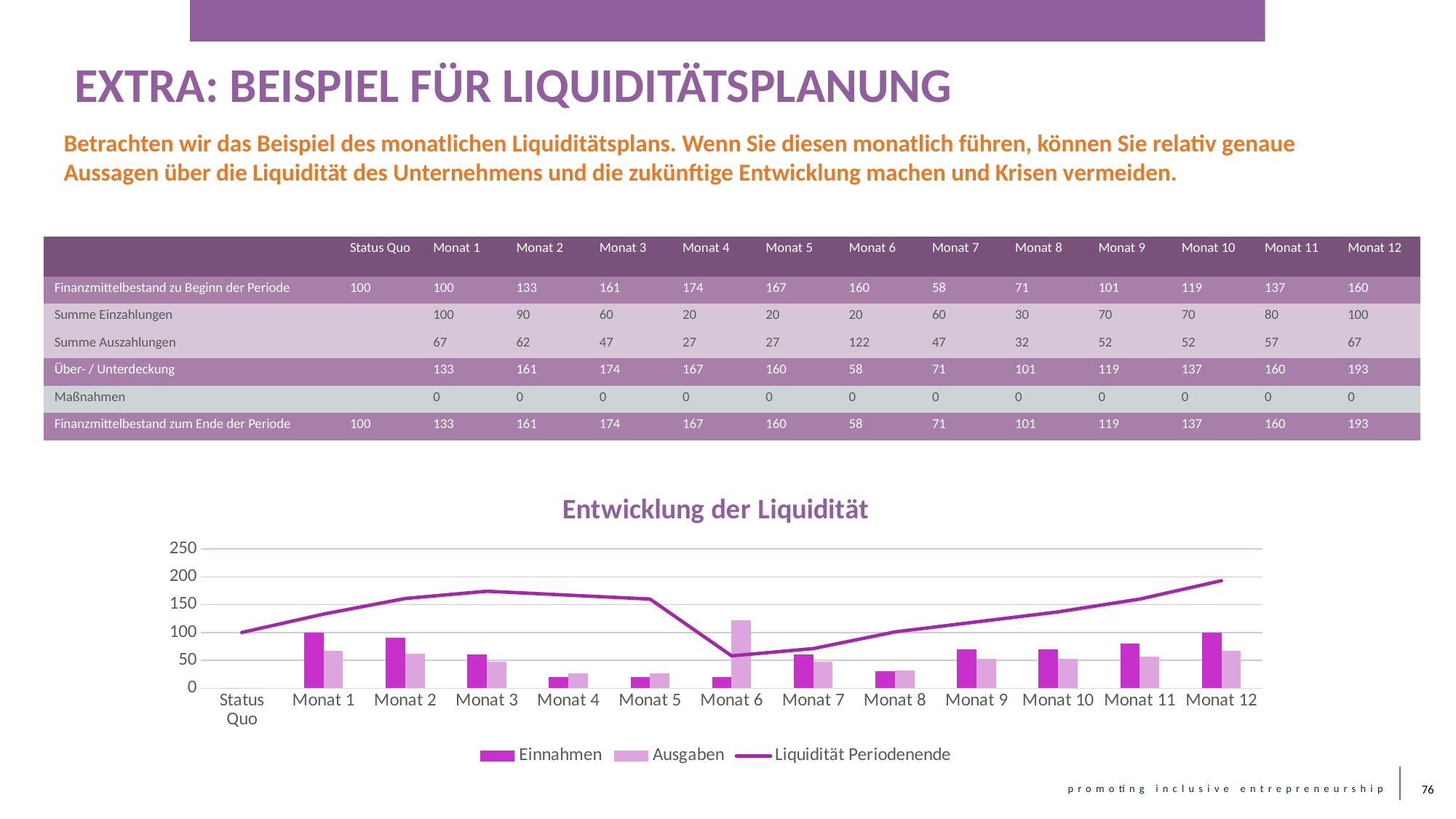
In the 'Entwicklung der Liquidität' chart, does the Liquidität Periodenende line rise or fall from Monat 6 to Monat 12? rise In the 'Entwicklung der Liquidität' chart, at which month is the Liquidität Periodenende line highest? Monat 12 In the 'Entwicklung der Liquidität' chart, which month has the highest Ausgaben bar? Monat 6 In the 'Entwicklung der Liquidität' chart, at which month is the Liquidität Periodenende line lowest? Monat 6 In the 'Entwicklung der Liquidität' chart, which is larger for Monat 6: Einnahmen or Ausgaben? Ausgaben What kind of chart is 'Entwicklung der Liquidität'? A bar chart combined with a line How many categories are shown on the x axis of the 'Entwicklung der Liquidität' chart? 13 In the 'Entwicklung der Liquidität' chart, is the Einnahmen value for Monat 4 greater or less than 50? less How many series does the legend of the 'Entwicklung der Liquidität' chart list? 3 In the 'Entwicklung der Liquidität' chart, what is the Liquidität Periodenende value at Status Quo? 100 In the 'Entwicklung der Liquidität' chart, which is larger for Monat 1: Einnahmen or Ausgaben? Einnahmen In the 'Entwicklung der Liquidität' chart, is the Ausgaben value for Monat 6 greater or less than 100? greater